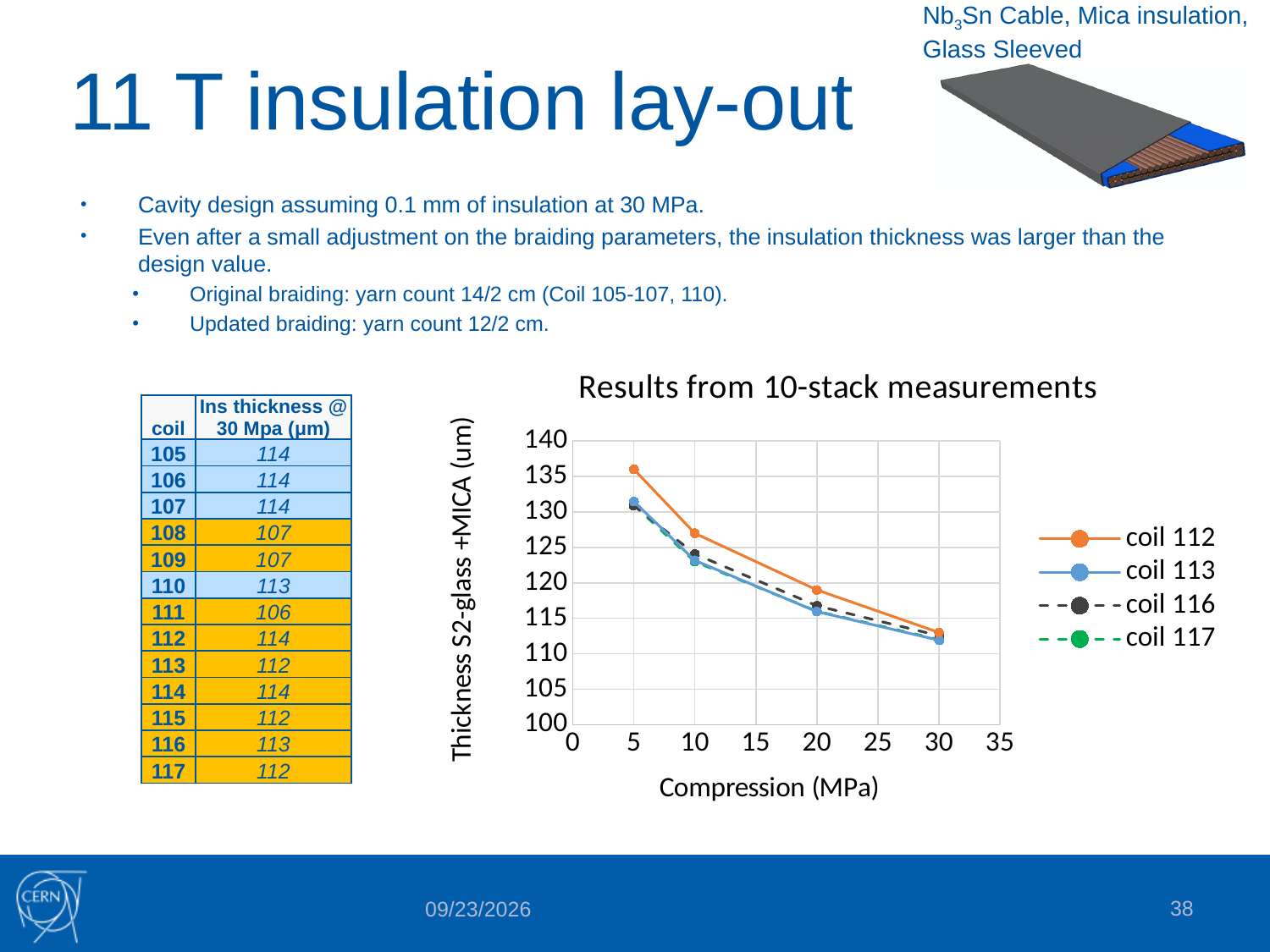
In the 'Results from 10-stack measurements' chart, is the value for coil 112 at 10 MPa greater or less than 125? greater How many compression points are plotted for each coil in the 'Results from 10-stack measurements' chart? 4 How many series does the legend of the 'Results from 10-stack measurements' chart list? 4 In the 'Results from 10-stack measurements' chart, is the value for coil 112 at 5 MPa greater or less than 130? greater What kind of chart is shown under the title 'Results from 10-stack measurements'? line chart In the 'Results from 10-stack measurements' chart, is the value for coil 113 at 30 MPa greater or less than 115? less What is the x-axis label of the 'Results from 10-stack measurements' chart? Compression (MPa) In the 'Results from 10-stack measurements' chart, which coil has the highest thickness at 5 MPa? coil 112 What is the y-axis label of the 'Results from 10-stack measurements' chart? Thickness S2-glass +MICA (um) In the 'Results from 10-stack measurements' chart, does the thickness rise or fall as compression increases? fall In the 'Results from 10-stack measurements' chart, which is larger at 10 MPa: coil 112 or coil 113? coil 112